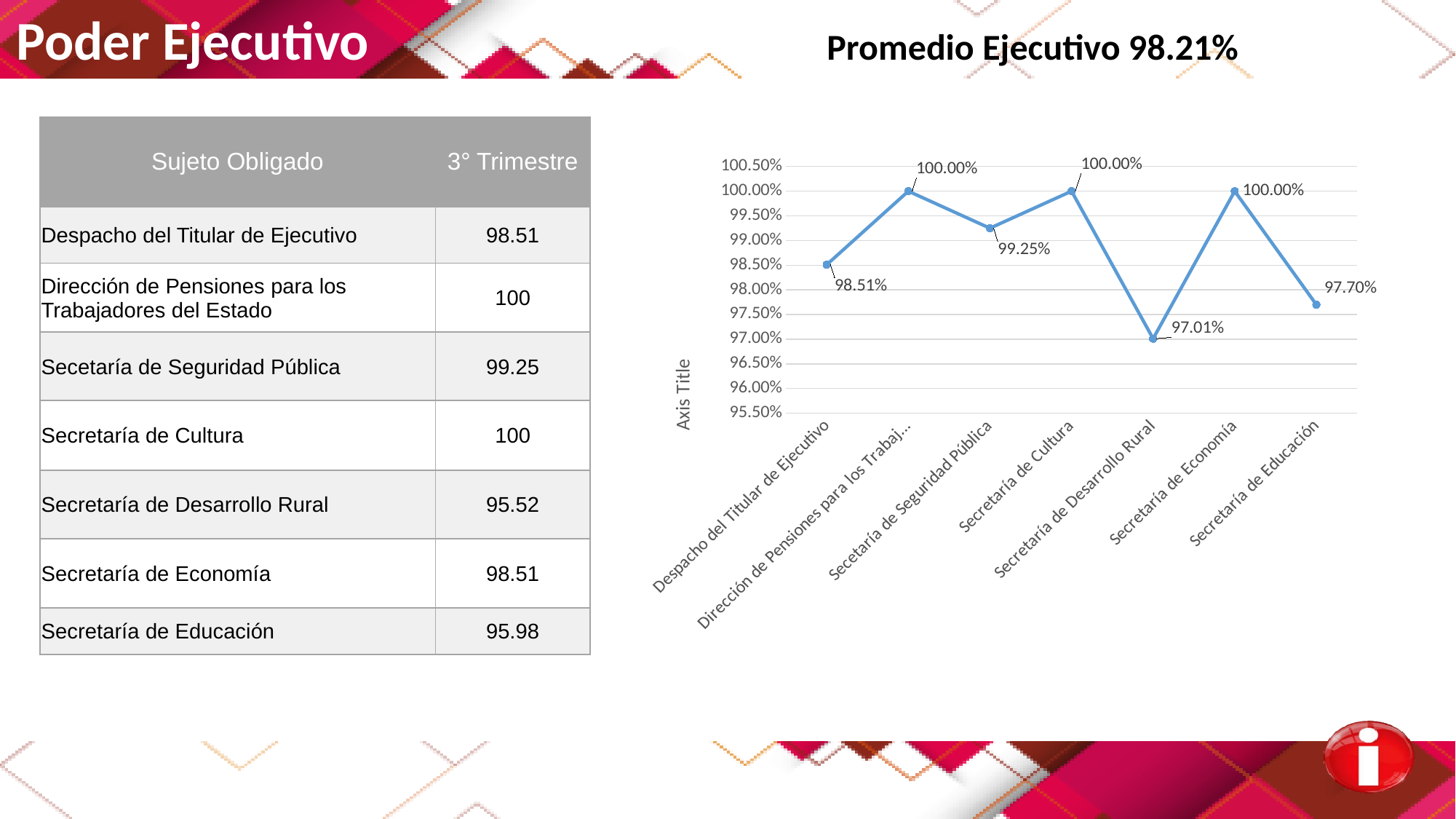
What is the label on the vertical axis of the chart? Axis Title In the chart, what is the difference between the value for Secretaría de Cultura and the value for Secretaría de Desarrollo Rural? 2.99 percentage points In the chart, what is the value for Secretaría de Seguridad Pública? 99.25% In the chart, what is the value for Secretaría de Educación? 97.70% In the chart, what is the value for Despacho del Titular de Ejecutivo? 98.51% Which category has the lowest value in the chart? Secretaría de Desarrollo Rural How many categories are plotted in the chart? 7 In the chart, what is the value for Secretaría de Desarrollo Rural? 97.01% In the chart, is the value for Secretaría de Educación greater or less than 98.00%? less In the chart, which is larger: the value for Despacho del Titular de Ejecutivo or the value for Secretaría de Educación? Despacho del Titular de Ejecutivo What kind of chart is shown on the slide? line chart In the chart, does the line rise or fall from Secretaría de Cultura to Secretaría de Desarrollo Rural? fall